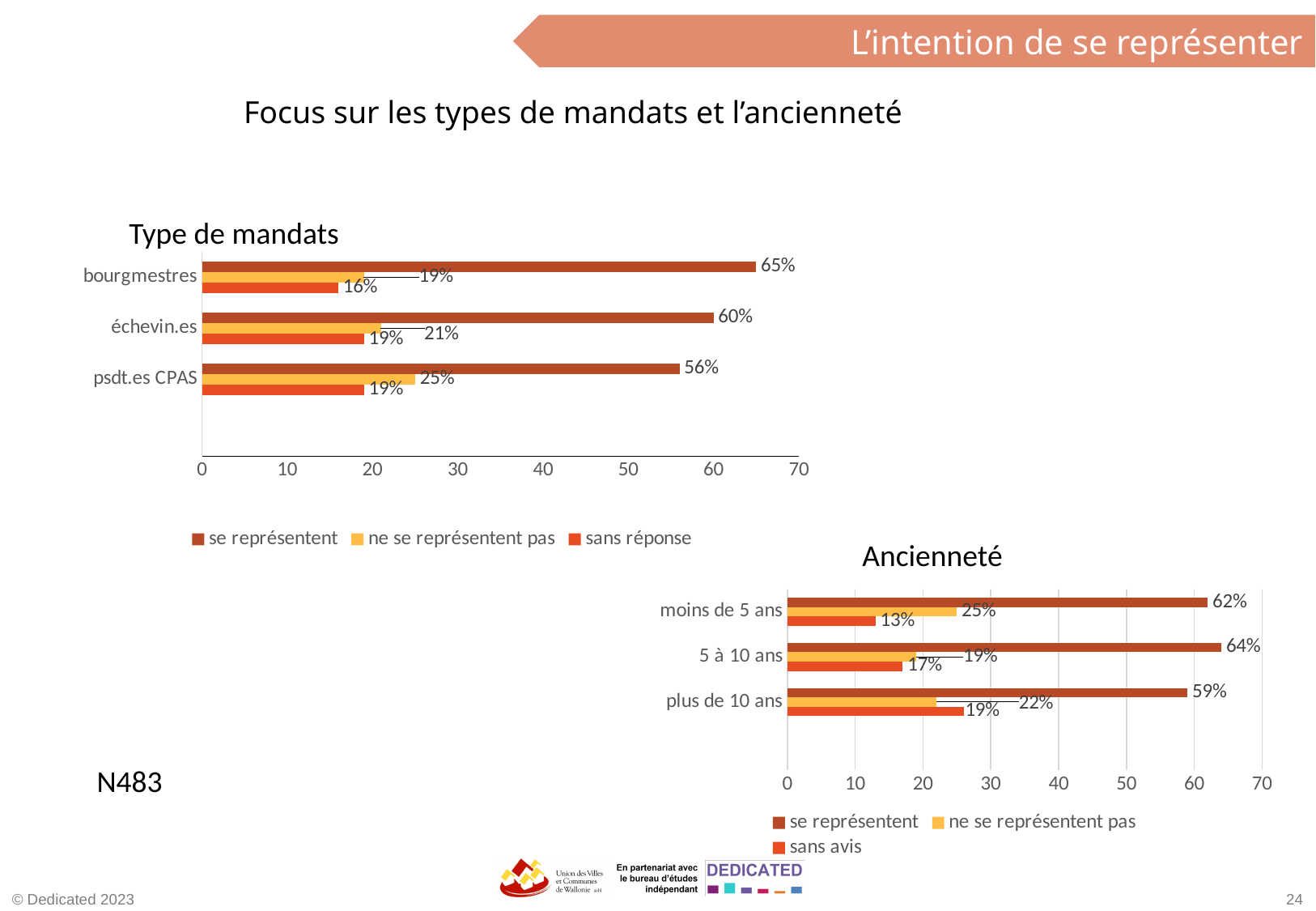
In the 'Ancienneté' chart, how many categories are shown on the vertical axis? 3 In the 'Type de mandats' chart, what is the difference between the 'se représentent' values for bourgmestres and psdt.es CPAS? 9 percentage points In the 'Type de mandats' chart, which category has the lowest 'sans réponse' value? bourgmestres In the 'Type de mandats' chart, what is the value of 'ne se représentent pas' for psdt.es CPAS? 25% In the 'Type de mandats' chart, how many series does the legend list? 3 In the 'Ancienneté' chart, what is the value of 'sans avis' for 'moins de 5 ans'? 13% In the 'Type de mandats' chart, which category has the highest 'se représentent' value? bourgmestres In the 'Ancienneté' chart, which category has the lowest 'se représentent' value? plus de 10 ans What type of chart is the 'Ancienneté' chart? bar chart In the 'Ancienneté' chart, what is the value of 'se représentent' for '5 à 10 ans'? 64% In the 'Ancienneté' chart, is the 'ne se représentent pas' value for 'moins de 5 ans' larger or smaller than that for '5 à 10 ans'? larger In the 'Type de mandats' chart, what is the value of 'se représentent' for bourgmestres? 65%